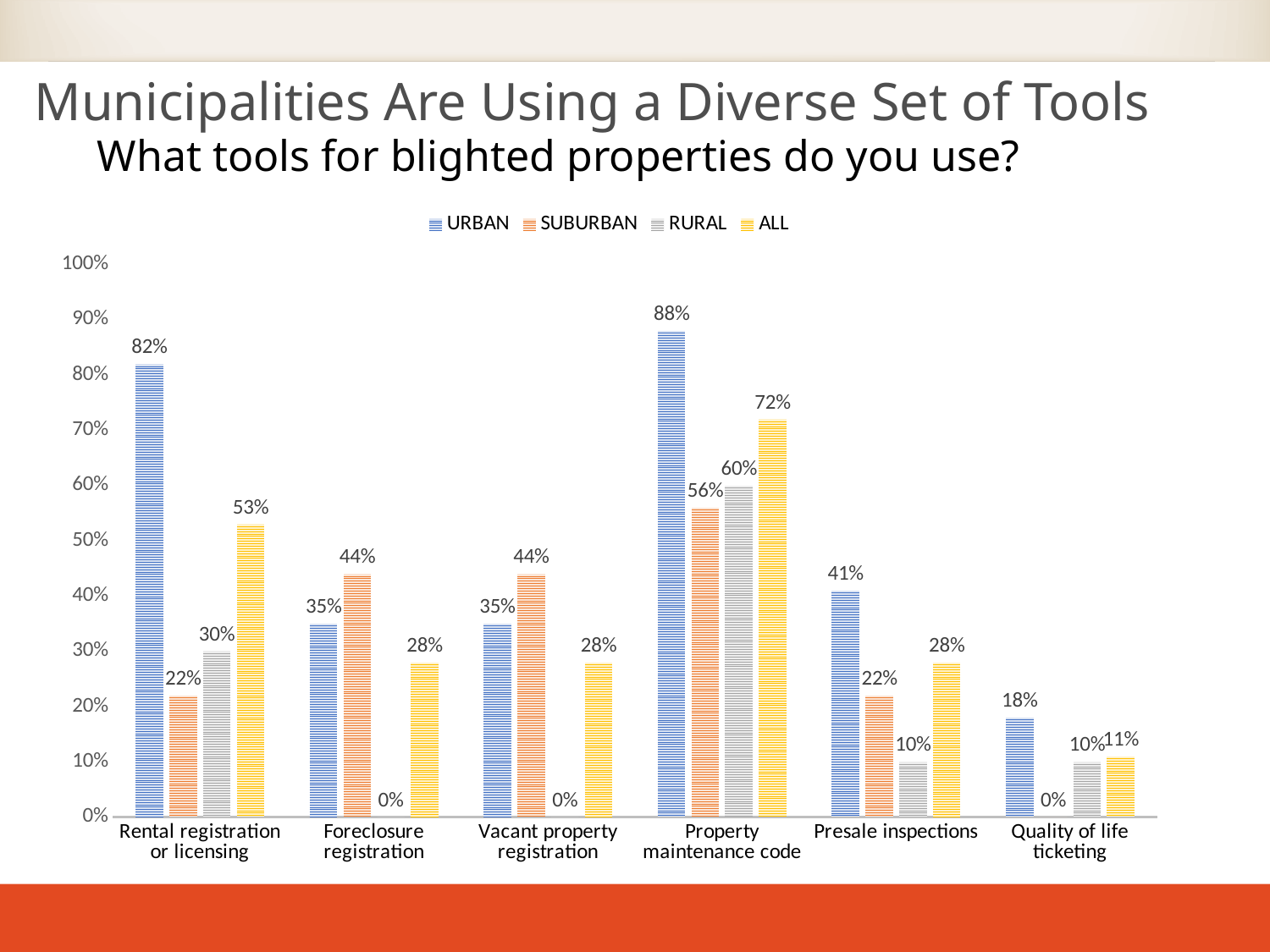
What question is the chart answering, according to the subtitle? What tools for blighted properties do you use? What is the RURAL value for Presale inspections? 10% What kind of chart is shown on the slide? Bar chart What is the URBAN value for Property maintenance code? 88% What is the SUBURBAN value for Quality of life ticketing? 0% Which is larger for Foreclosure registration, the URBAN value or the SUBURBAN value? SUBURBAN How many series does the legend list? 4 What is the difference between the URBAN and SUBURBAN values for Rental registration or licensing? 60% Which category has the lowest ALL value? Quality of life ticketing How many categories are shown on the x axis? 6 Which category has the highest URBAN value? Property maintenance code What is the ALL value for Rental registration or licensing? 53%